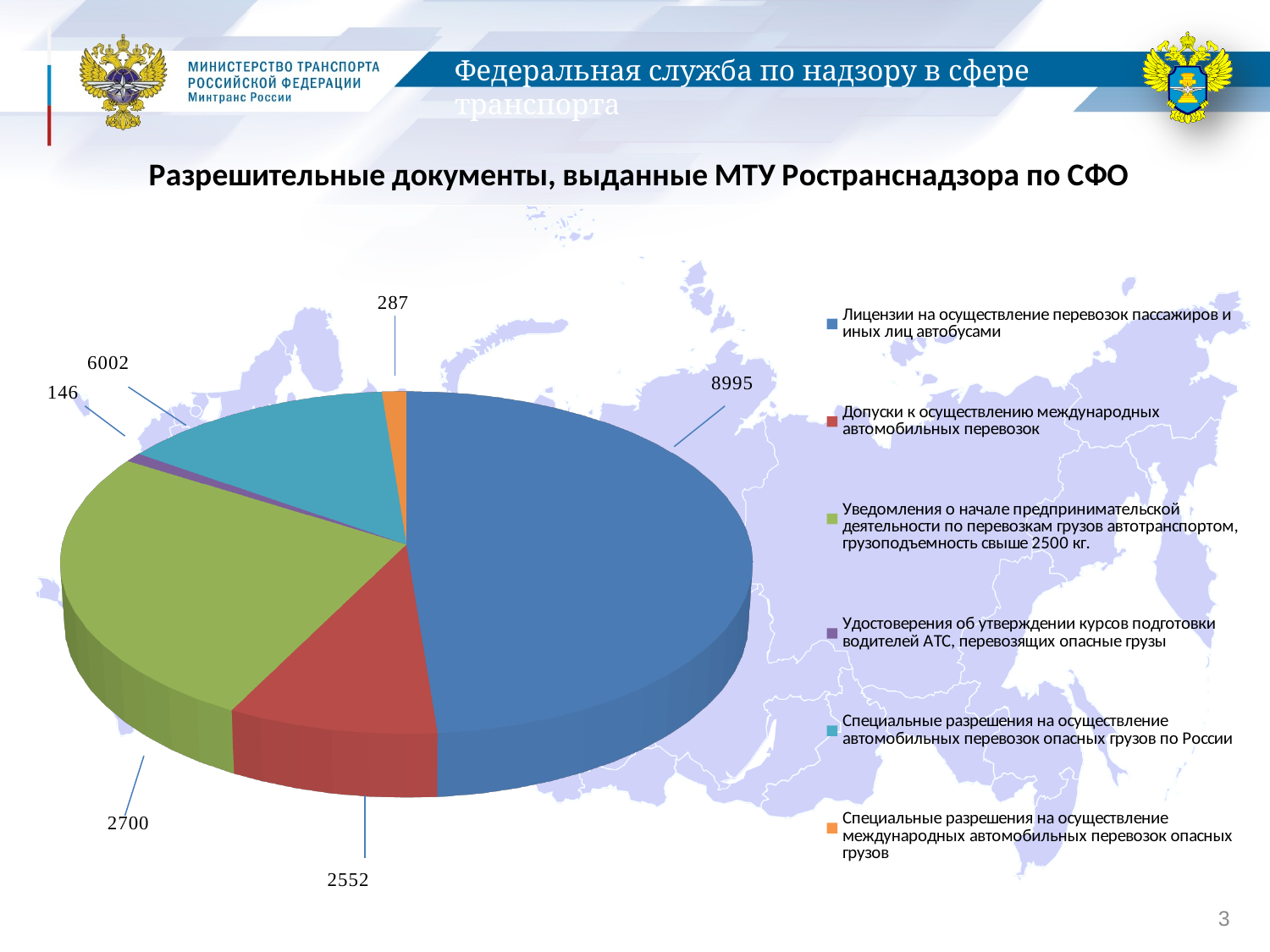
Which category has the smallest slice of the pie? Удостоверения об утверждении курсов подготовки водителей АТС, перевозящих опасные грузы What is the value for "Специальные разрешения на осуществление международных автомобильных перевозок опасных грузов"? 287 Which is larger: the value for bus passenger transport licences or the value for international road transport admissions? bus passenger transport licences (8995) What is the value for "Лицензии на осуществление перевозок пассажиров и иных лиц автобусами"? 8995 What is the value for "Удостоверения об утверждении курсов подготовки водителей АТС, перевозящих опасные грузы"? 146 Which category has the largest slice of the pie? Лицензии на осуществление перевозок пассажиров и иных лиц автобусами How many categories does the legend of the pie chart list? 6 What type of chart is shown on the slide? pie chart What is the title of the chart on the slide? Разрешительные документы, выданные МТУ Ространснадзора по СФО What is the difference between the value for bus passenger transport licences (8995) and the value for international road transport admissions (2552)? 6443 What is the value for "Допуски к осуществлению международных автомобильных перевозок"? 2552 What colour is the slice for "Лицензии на осуществление перевозок пассажиров и иных лиц автобусами"? blue